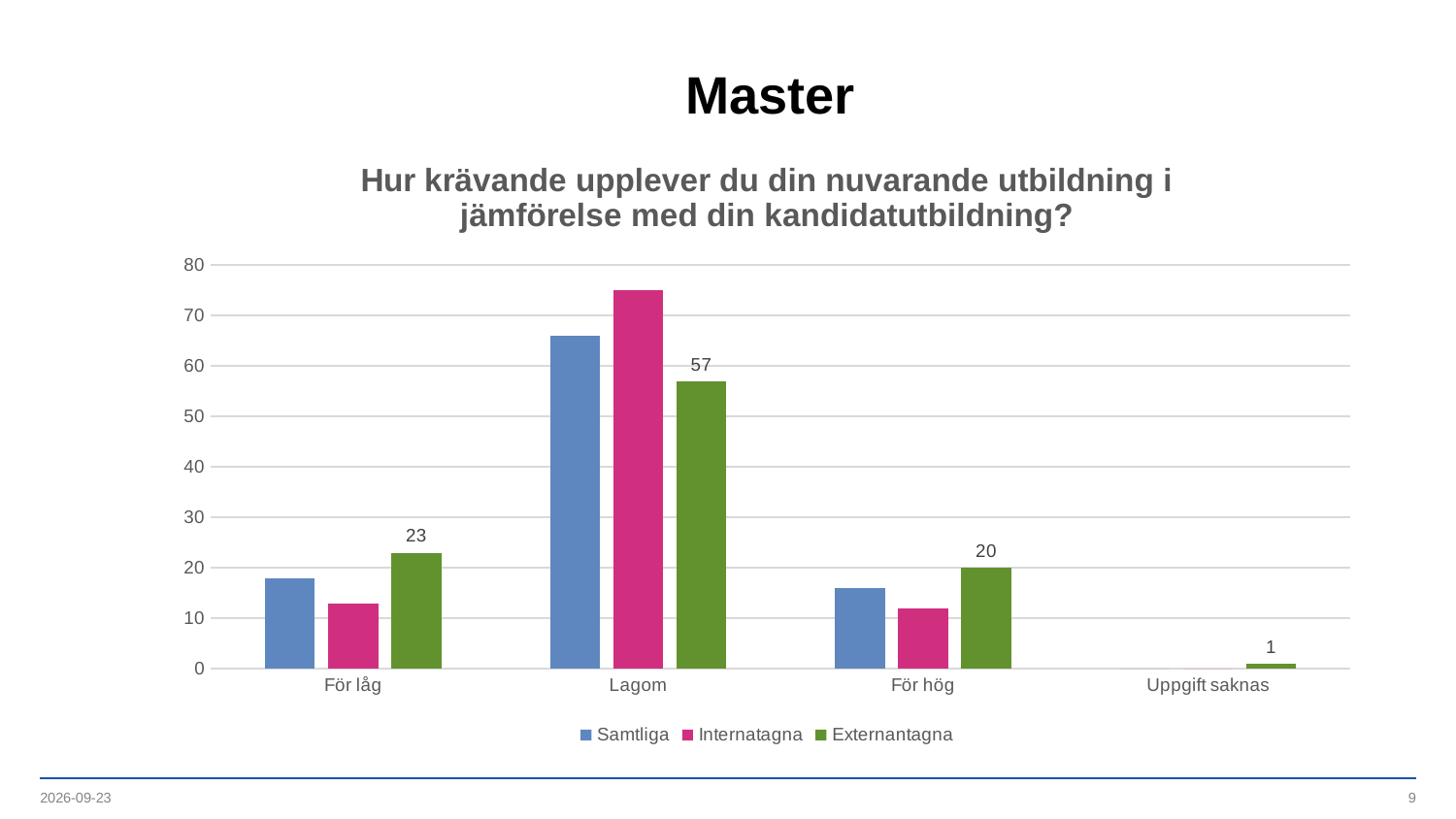
In the Lagom category, which series has the larger value: Internatagna or Externantagna? Internatagna What is the value for Externantagna in the Uppgift saknas category? 1 What is the value for Externantagna in the För låg category? 23 Which category has the lowest value for the Externantagna series? Uppgift saknas Is the value for Samtliga in the För låg category greater or less than 20? less Is the value for Internatagna in the Lagom category greater or less than 70? greater How many categories are shown on the x axis? 4 What kind of chart is shown on the slide? Bar chart What is the value for Externantagna in the Lagom category? 57 What is the difference between the Externantagna values for Lagom and För låg? 34 How many series does the legend list? 3 Which category has the highest value for the Externantagna series? Lagom